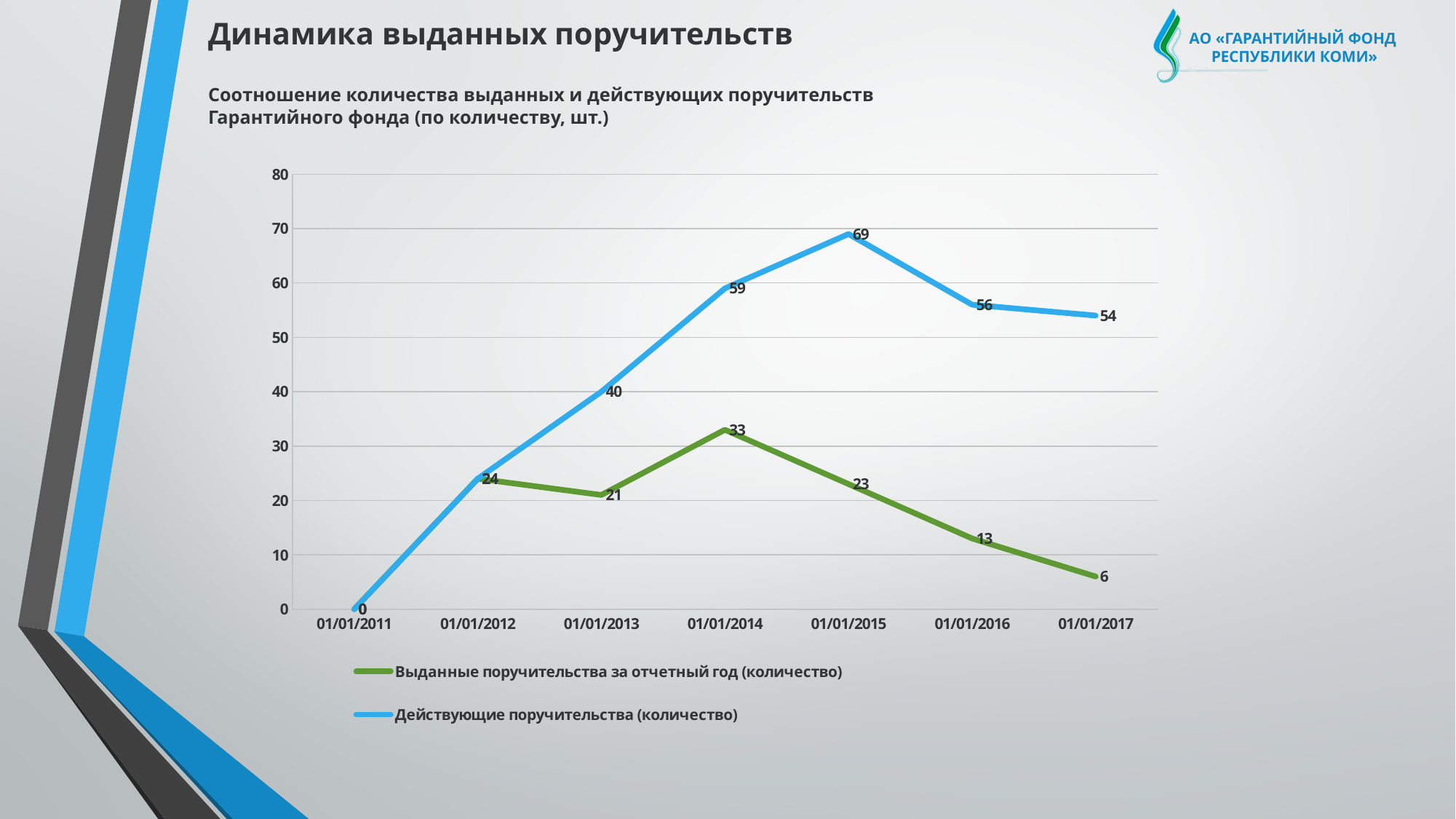
Does Выданные поручительства за отчетный год (количество) rise or fall from 01/01/2014 to 01/01/2017? fall On which date does Действующие поручительства (количество) reach its highest value? 01/01/2015 What is the value of Действующие поручительства (количество) on 01/01/2017? 54 What is the value of Выданные поручительства за отчетный год (количество) on 01/01/2014? 33 What type of chart is shown on the slide? line chart Which is larger on 01/01/2014: Действующие поручительства or Выданные поручительства за отчетный год? Действующие поручительства How many dates are shown on the x axis? 7 What is the value of Выданные поручительства за отчетный год (количество) on 01/01/2017? 6 What is the difference between Действующие поручительства and Выданные поручительства за отчетный год on 01/01/2016? 43 On which date is Выданные поручительства за отчетный год (количество) lowest? 01/01/2011 How many series does the legend list? 2 What is the value of Действующие поручительства (количество) on 01/01/2015? 69